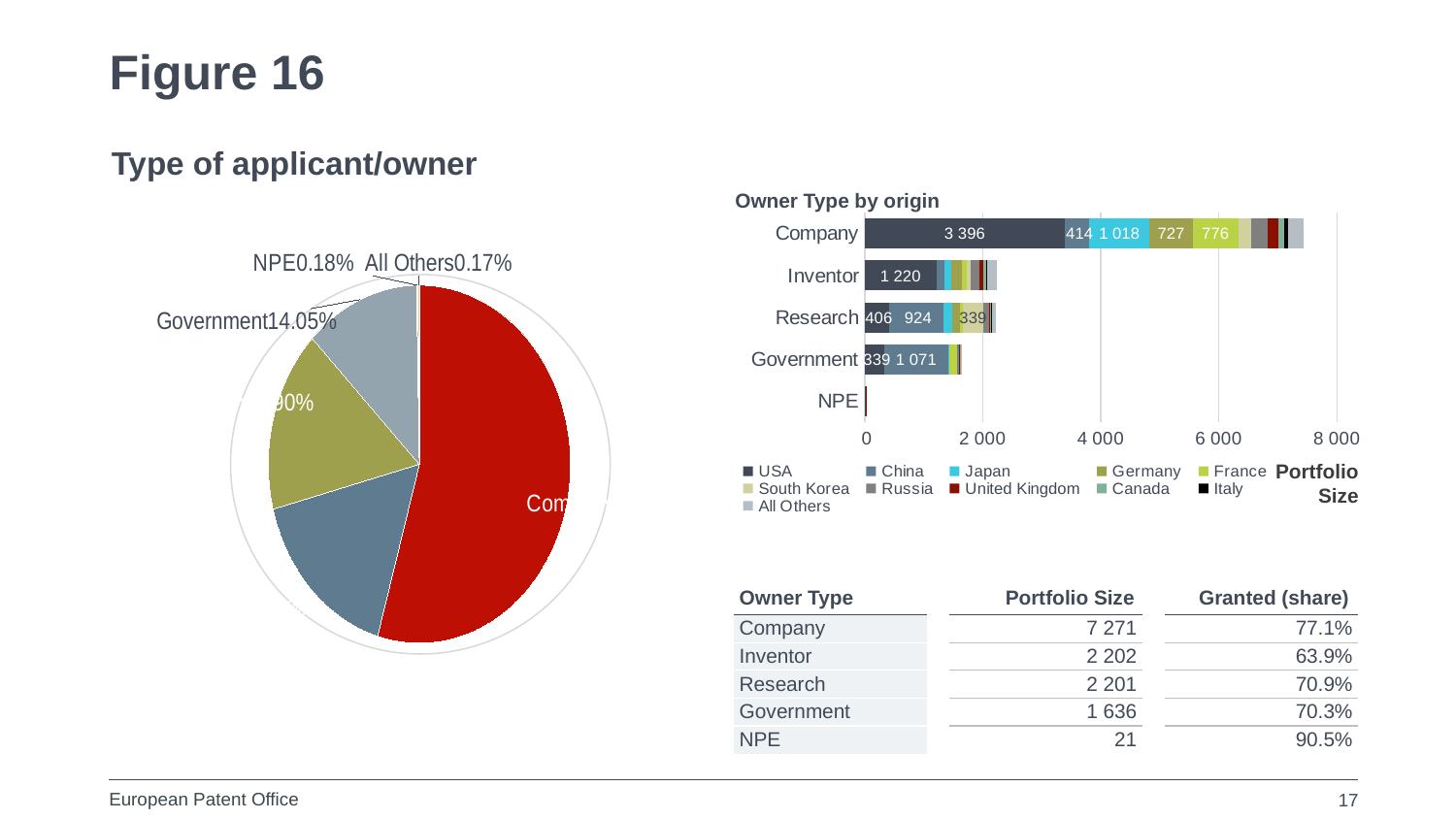
In the 'Owner Type by origin' chart, how many owner type categories are shown on the vertical axis? 5 In the pie chart, what share is shown for Government? 14.05% In the 'Owner Type by origin' chart, which owner type has the shortest bar? NPE In the pie chart, what share is shown for NPE? 0.18% In the 'Owner Type by origin' chart, how many series does the legend list? 11 In the 'Owner Type by origin' chart, what is the difference between the USA value for Company and the USA value for Inventor? 2 176 In the 'Owner Type by origin' chart, what is the China value for Government? 1 071 In the pie chart, which is larger, the NPE slice or the All Others slice? NPE What kind of chart is the chart on the left of the slide? Pie chart In the 'Owner Type by origin' chart, which owner type has the longest bar? Company What kind of chart is the 'Owner Type by origin' chart? Bar chart In the 'Owner Type by origin' chart, what is the USA value for Company? 3 396